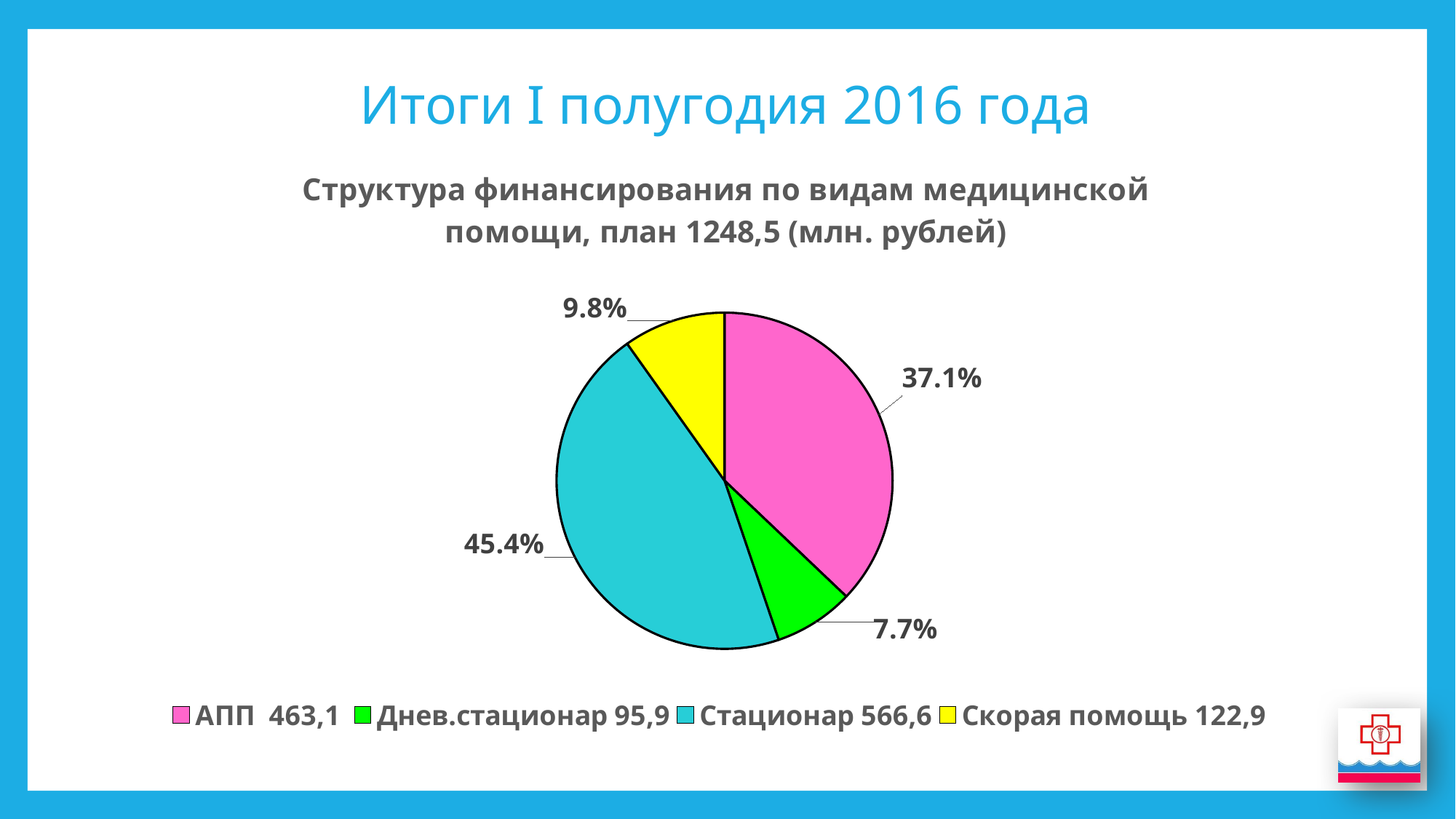
What is the difference in percentage points between the Стационар slice and the АПП slice? 8.3 Which category has the largest slice of the pie? Стационар What is the value shown in the legend for АПП? 463,1 How many slices does the pie chart have? 4 What is the value shown in the legend for Скорая помощь? 122,9 What kind of chart is shown on the slide? pie chart What share of the pie does АПП represent? 37.1% Which is larger, the slice for АПП or the slice for Скорая помощь? АПП Which category has the smallest slice of the pie? Днев.стационар What share of the pie does Скорая помощь represent? 9.8% What share of the pie does Днев.стационар represent? 7.7%